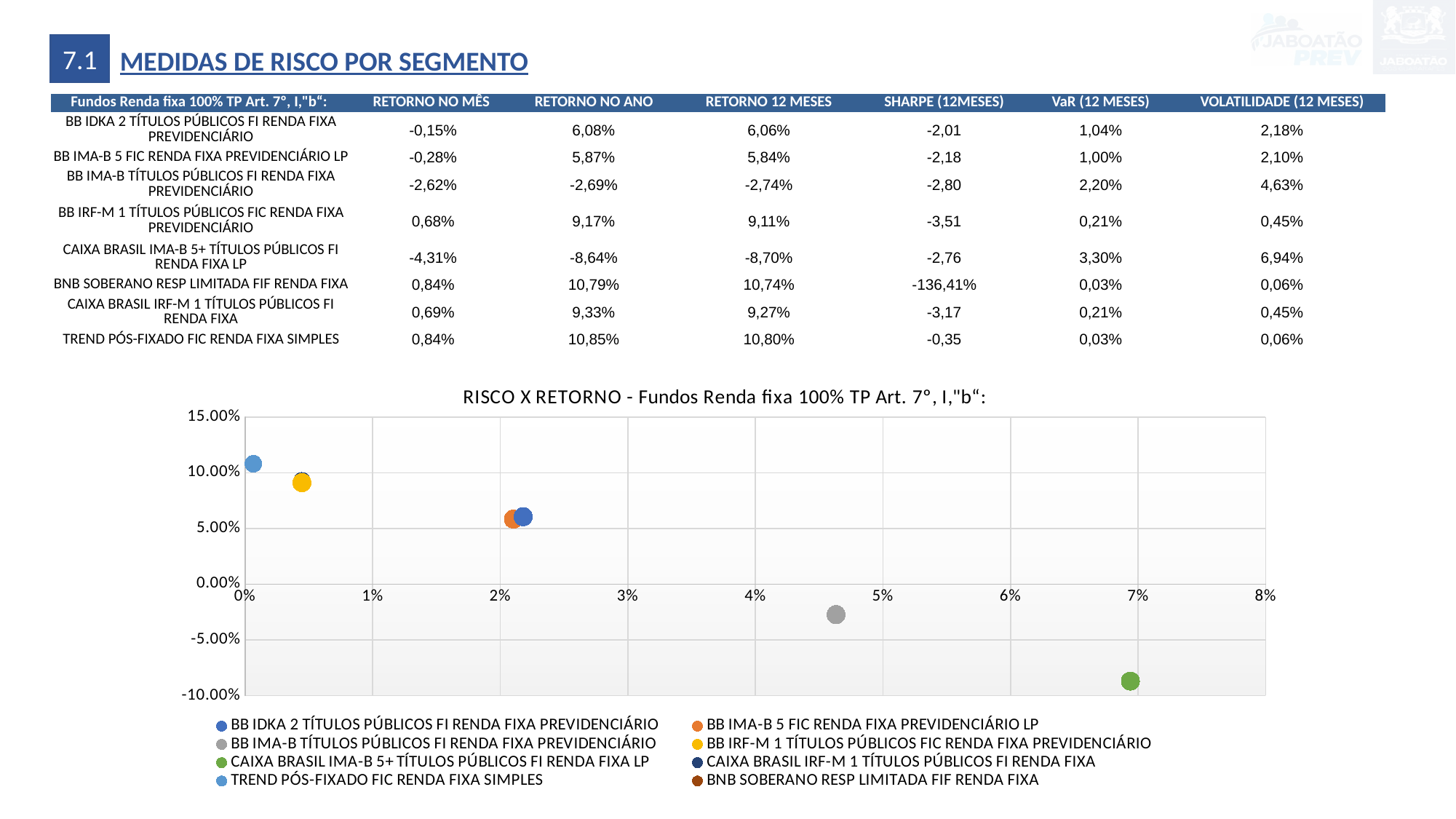
In the RISCO X RETORNO chart, is the x-axis value for CAIXA BRASIL IMA-B 5+ TÍTULOS PÚBLICOS FI RENDA FIXA LP greater or less than 6%? greater In the RISCO X RETORNO chart, is the y-axis value for BB IRF-M 1 TÍTULOS PÚBLICOS FIC RENDA FIXA PREVIDENCIÁRIO greater or less than 5.00%? greater In the RISCO X RETORNO chart, is the x-axis value for BB IMA-B TÍTULOS PÚBLICOS FI RENDA FIXA PREVIDENCIÁRIO greater or less than 4%? greater In the RISCO X RETORNO chart, which has the higher y-axis value: BB IMA-B TÍTULOS PÚBLICOS FI RENDA FIXA PREVIDENCIÁRIO or CAIXA BRASIL IMA-B 5+ TÍTULOS PÚBLICOS FI RENDA FIXA LP? BB IMA-B TÍTULOS PÚBLICOS FI RENDA FIXA PREVIDENCIÁRIO In the RISCO X RETORNO chart, which fund has the lowest return (y-axis value)? CAIXA BRASIL IMA-B 5+ TÍTULOS PÚBLICOS FI RENDA FIXA LP In the RISCO X RETORNO chart, do the y-axis values generally rise or fall as the x-axis value increases? fall What kind of chart is the RISCO X RETORNO chart? scatter chart What colour is the marker for CAIXA BRASIL IMA-B 5+ TÍTULOS PÚBLICOS FI RENDA FIXA LP in the RISCO X RETORNO chart? green In the RISCO X RETORNO chart, which has the higher y-axis value: BB IRF-M 1 TÍTULOS PÚBLICOS FIC RENDA FIXA PREVIDENCIÁRIO or BB IMA-B 5 FIC RENDA FIXA PREVIDENCIÁRIO LP? BB IRF-M 1 TÍTULOS PÚBLICOS FIC RENDA FIXA PREVIDENCIÁRIO How many series does the legend of the RISCO X RETORNO chart list? 8